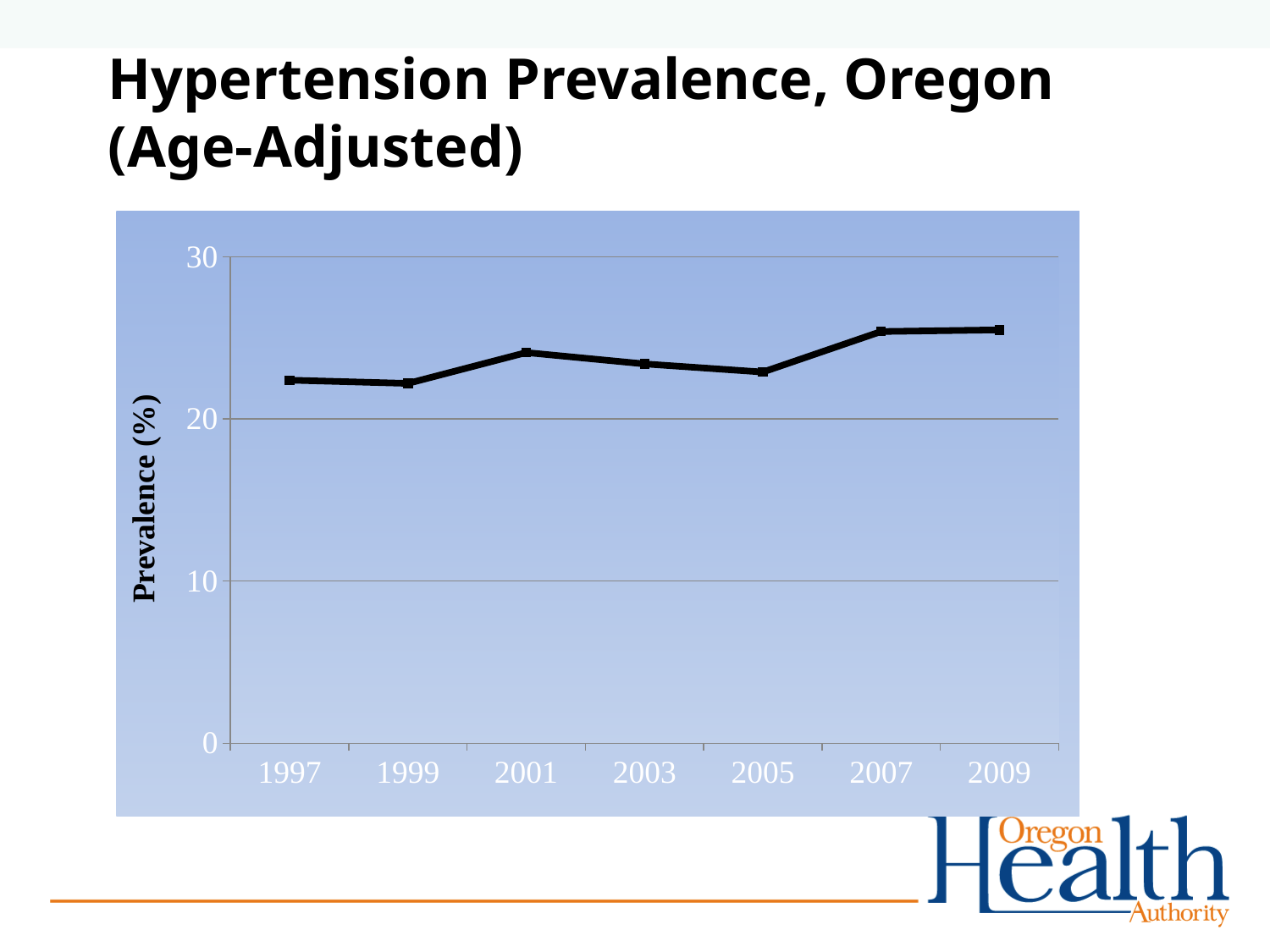
What is the title of the slide? Hypertension Prevalence, Oregon (Age-Adjusted) Overall, does hypertension prevalence rise or fall from 1997 to 2009? rise Which year has the higher prevalence, 2005 or 2007? 2007 Is the prevalence value for 2009 greater or less than 30? less How many years are plotted along the x axis? 7 Is the prevalence value for 2001 greater or less than 30? less What kind of chart is shown on the slide? line chart Is the prevalence value for 2005 greater or less than 20? greater Which year has the higher prevalence, 1999 or 2001? 2001 What is the label on the y axis? Prevalence (%) Which year has the higher prevalence, 1997 or 2009? 2009